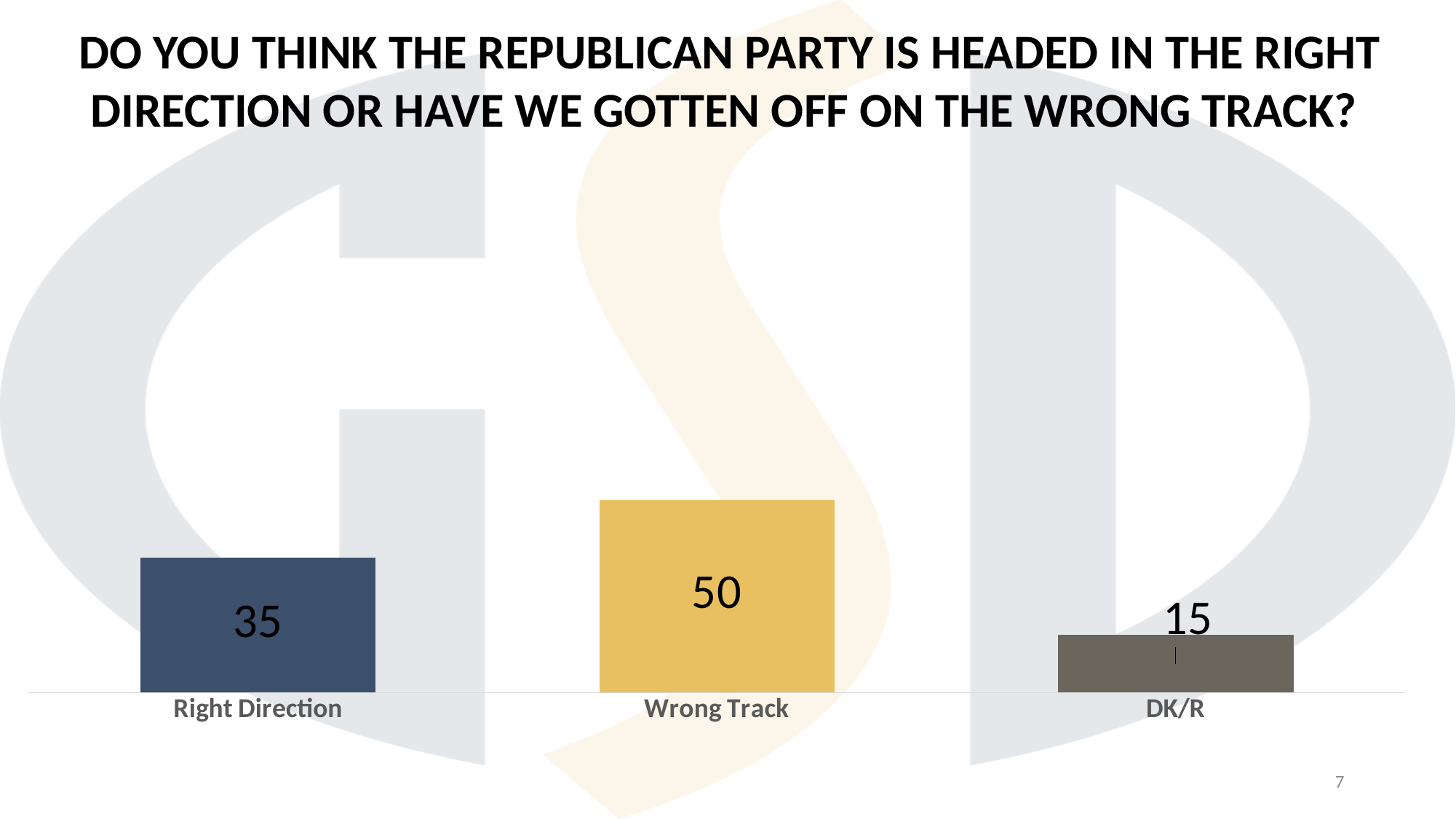
What is the value for DK/R? 15 What colour is the bar for Wrong Track? Yellow Which is larger, the value for Right Direction or the value for DK/R? Right Direction How many categories are shown in the chart? 3 What is the value for Wrong Track? 50 What is the total of the three values shown in the chart? 100 What is the value for Right Direction? 35 What kind of chart is shown on the slide? Bar chart What is the difference between the values for Wrong Track and Right Direction? 15 What is the difference between the values for Right Direction and DK/R? 20 Which category has the highest value? Wrong Track Which category has the lowest value? DK/R